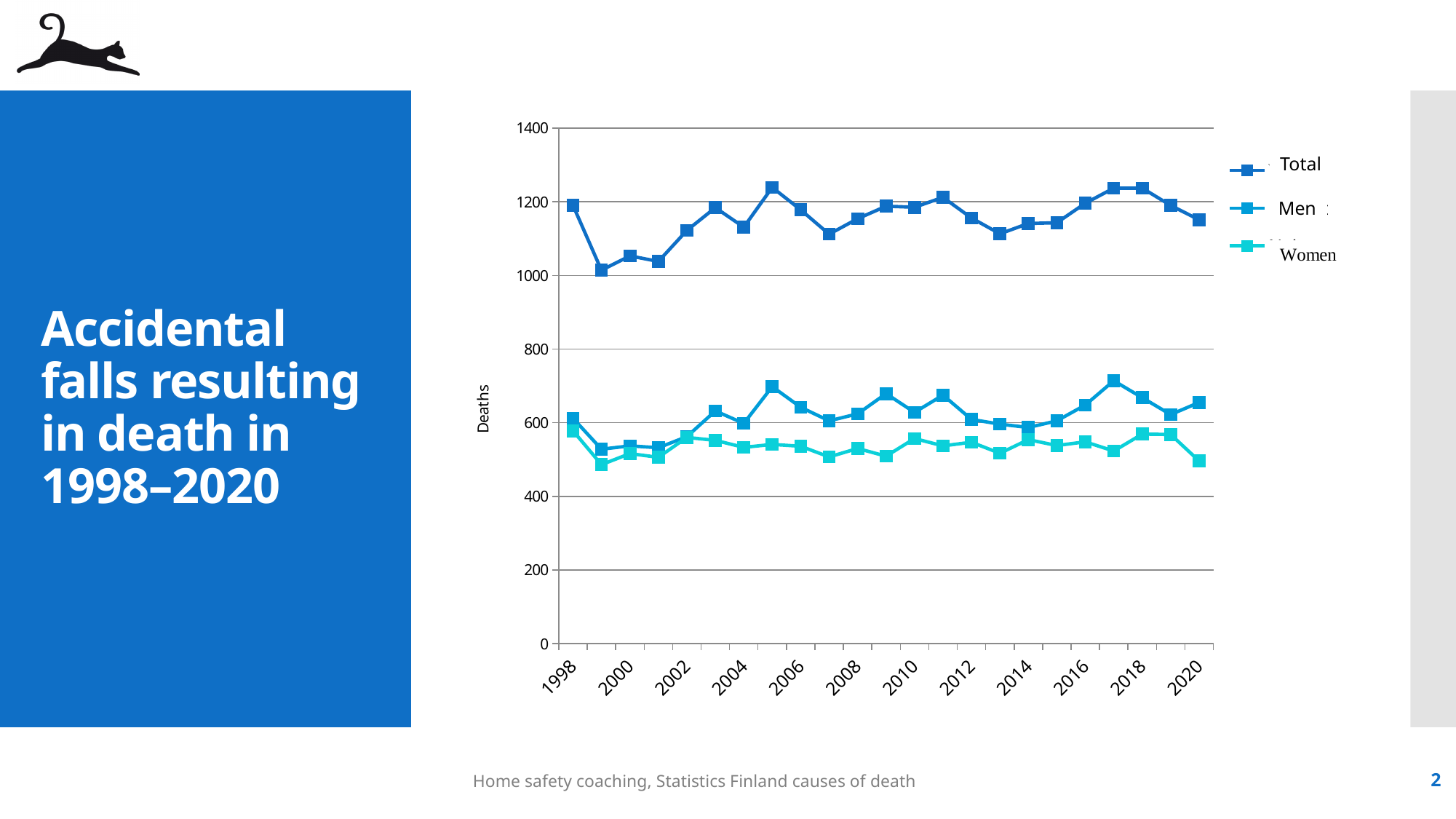
Which series are listed in the legend? Total, Men, Women Is the value for Men in 2017 greater or less than 600? greater Is the value for Total in 2005 greater or less than 1200? greater Is the value for Women in 2020 greater or less than 600? less Which is larger in 2017, the value for Men or the value for Women? Men What kind of chart is shown on the slide? line chart How many series does the legend list? 3 How many years (data points per series) are plotted along the x axis? 23 What is the label on the vertical axis? Deaths In which year is the Total series at its lowest? 1999 Does the Total series rise or fall from 1998 to 1999? fall